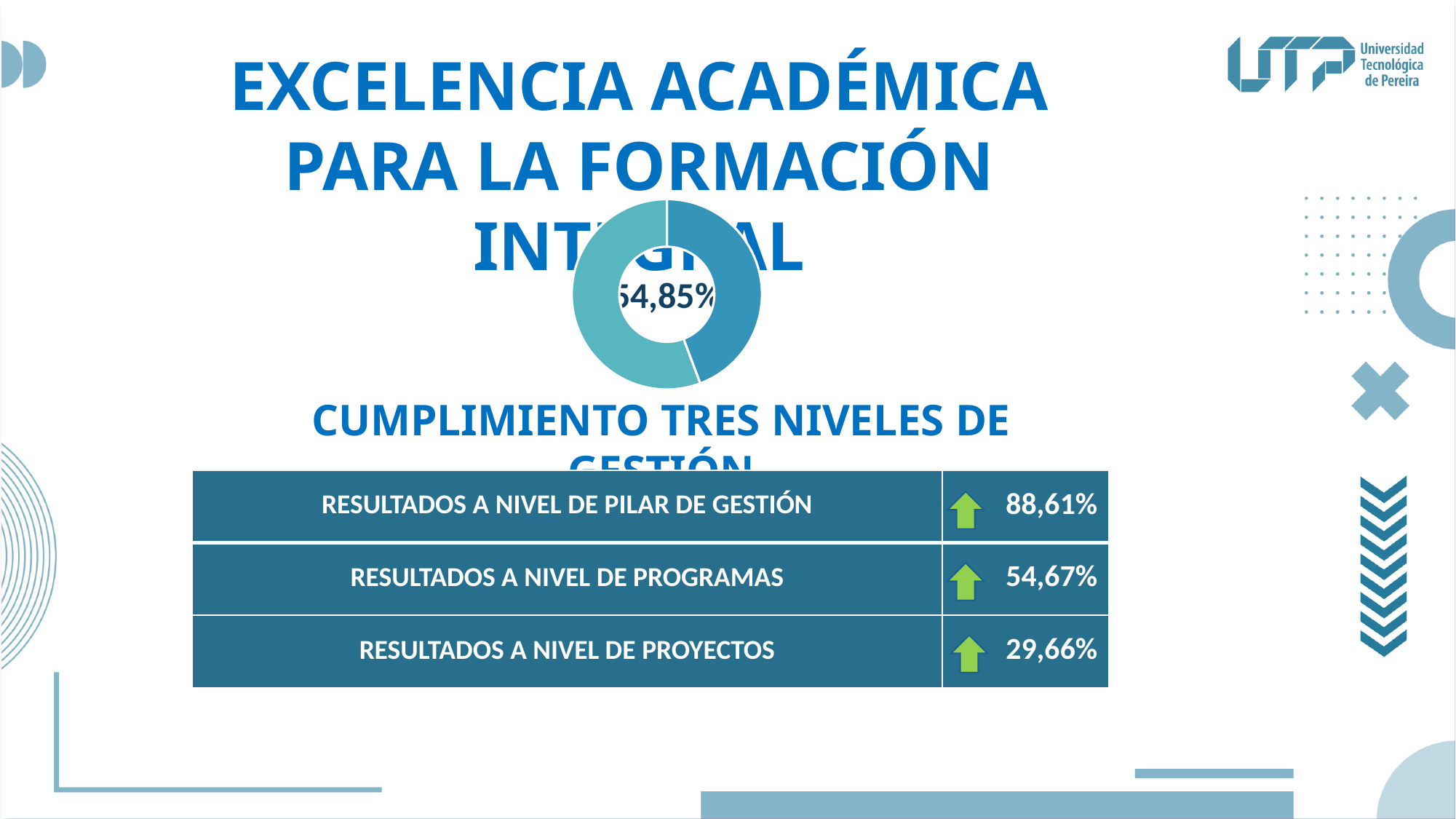
Which slice of the doughnut chart is larger, the dark blue one or the light teal one? The light teal one Does the doughnut chart display a legend? No What kind of chart is shown in the middle of the slide? Doughnut chart How many slices does the doughnut chart have? 2 What percentage is printed in the centre of the doughnut chart? 54,85% Is the value printed in the centre of the doughnut chart greater or less than 50%? greater